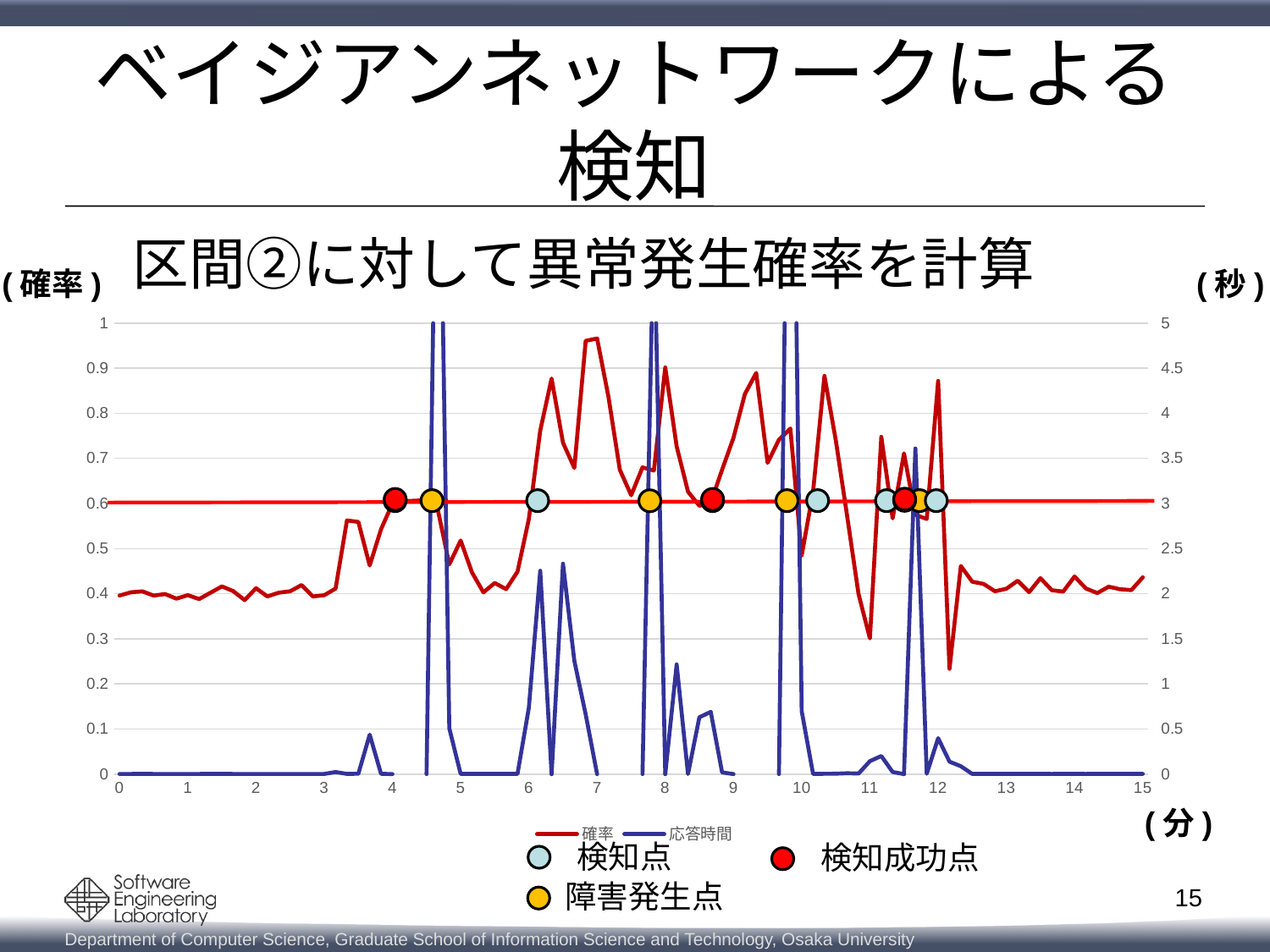
What colour is the 応答時間 line in the chart? blue Is the 確率 value at x = 7 greater or less than 0.9? greater Is the 確率 value at x = 0 greater or less than 0.5? less Which is larger, the 確率 value at x = 7 or the 確率 value at x = 0? x = 7 What kind of chart is shown on the slide? line chart How many series does the chart legend list? 2 Is the 応答時間 value at x = 2 greater or less than 0.5 on the right axis? less What is the maximum value shown on the right-hand (秒) axis? 5 Does the 確率 line rise or fall between x = 3 and x = 4? rise What are the two series named in the chart legend? 確率 and 応答時間 At what value on the left axis is the horizontal red threshold line drawn? 0.6